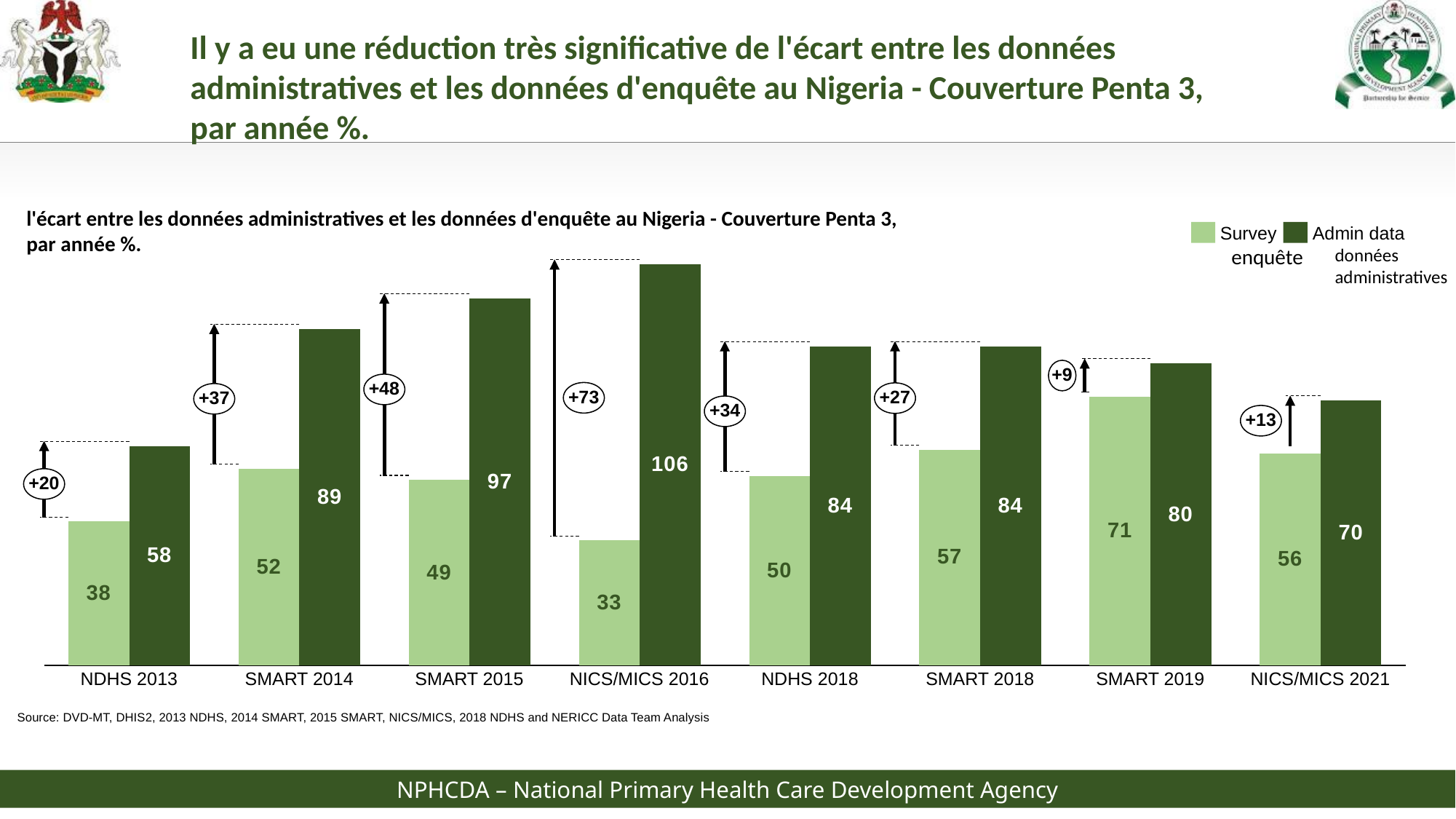
Which series is shown in dark green? Admin data Which category has the lowest Survey value? NICS/MICS 2016 What is the Survey value for SMART 2019? 71 What is the Survey value for NDHS 2013? 38 How many categories are shown on the x axis? 8 Which is larger for NICS/MICS 2021: the Survey value or the Admin data value? Admin data How many series does the legend list? 2 Which category has the highest Admin data value? NICS/MICS 2016 What is the Admin data value for NICS/MICS 2016? 106 What is the difference between the Admin data and Survey values for SMART 2015? 48 What is the gap between Admin data and Survey values shown for SMART 2019? +9 What kind of chart is shown on the slide? Bar chart